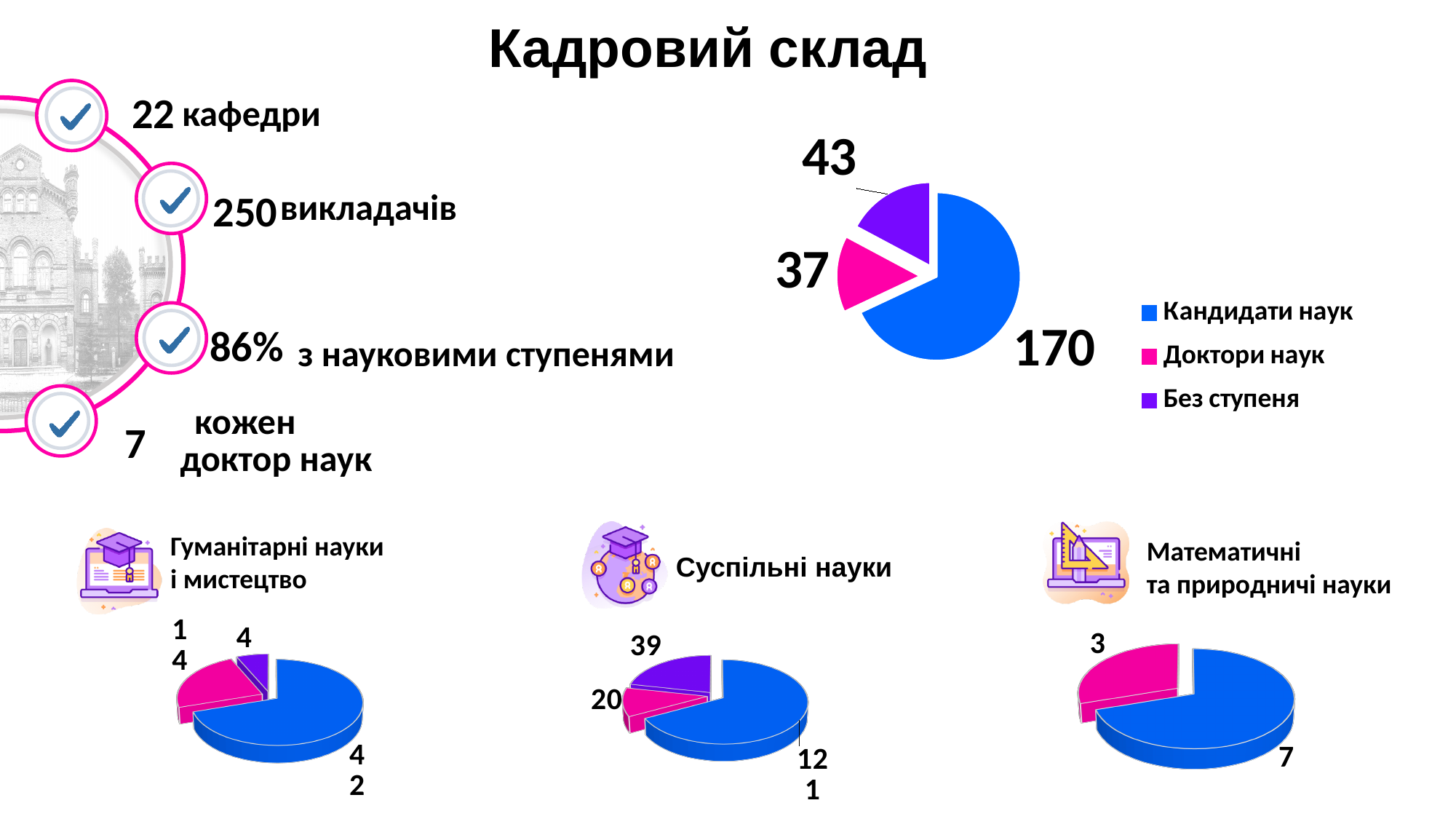
In the Суспільні науки pie chart at the bottom of the slide, what is the value of the largest (blue) slice? 121 In the Математичні та природничі науки pie chart at the bottom right, how many slices are there? 2 In the top-right pie chart, what is the value for Кандидати наук? 170 In the top-right pie chart, which is larger: Без ступеня or Доктори наук? Без ступеня In the top-right pie chart, what is the difference between the values for Кандидати наук and Без ступеня? 127 In the top-right pie chart, which category has the smallest slice? Доктори наук In the top-right pie chart, which category has the largest slice? Кандидати наук In the top-right pie chart, what is the value for Без ступеня? 43 How many entries does the legend of the top-right pie chart list? 3 In the top-right pie chart, what share of the total does Кандидати наук represent? 68% What kind of chart is the large chart at the top right of the slide? Pie chart In the top-right pie chart, what is the value for Доктори наук? 37